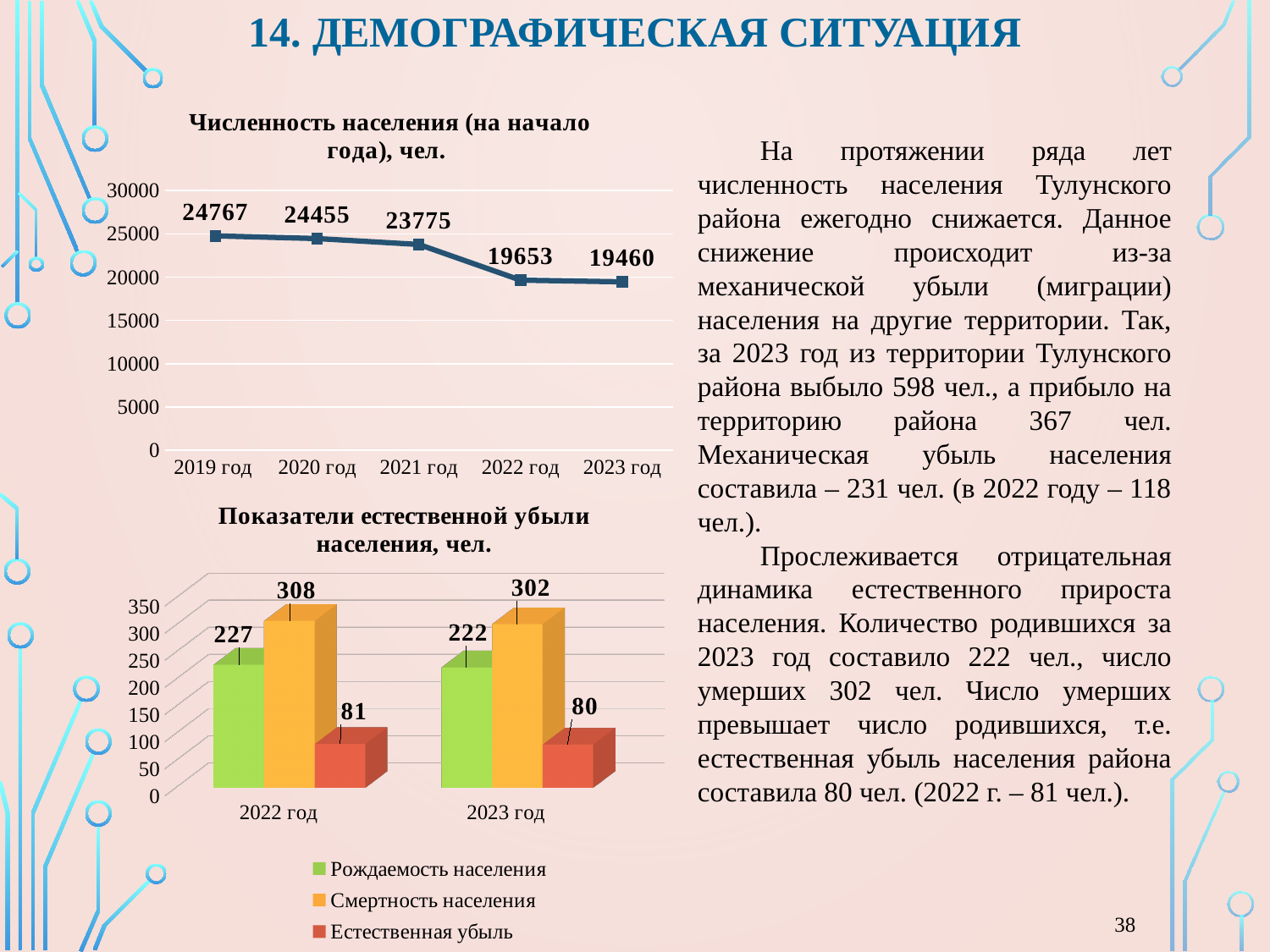
In the chart 'Показатели естественной убыли населения, чел.', what is the value of Смертность населения for 2023 год? 302 In the chart 'Численность населения (на начало года), чел.', how many years are plotted? 5 In the chart 'Показатели естественной убыли населения, чел.', which is larger for 2022 год: Рождаемость населения or Смертность населения? Смертность населения In the chart 'Численность населения (на начало года), чел.', do the values rise or fall from 2019 год to 2023 год? fall In the chart 'Численность населения (на начало года), чел.', which year has the lowest population? 2023 год In the chart 'Численность населения (на начало года), чел.', what is the population value for 2021 год? 23775 What type of chart is 'Показатели естественной убыли населения, чел.'? bar chart In the chart 'Показатели естественной убыли населения, чел.', what is the value of Рождаемость населения for 2022 год? 227 In the chart 'Показатели естественной убыли населения, чел.', what is the difference between Смертность населения and Рождаемость населения in 2023 год? 80 In the chart 'Численность населения (на начало года), чел.', what is the difference between the 2019 год and 2023 год values? 5307 What type of chart is 'Численность населения (на начало года), чел.'? line chart In the chart 'Показатели естественной убыли населения, чел.', how many series does the legend list? 3